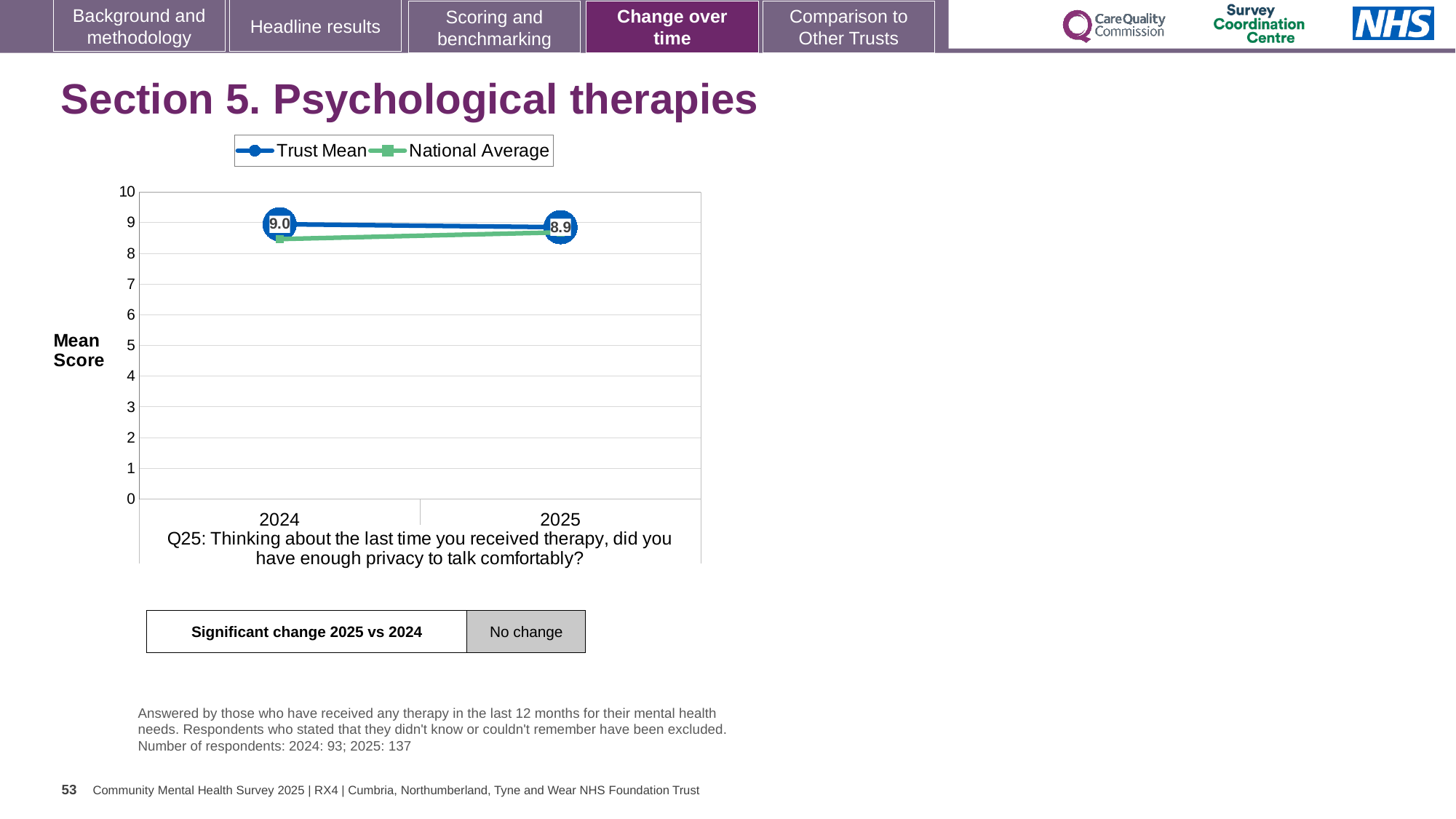
In 2024, which is larger: the Trust Mean or the National Average? Trust Mean Does the Trust Mean rise or fall from 2024 to 2025? fall What kind of chart is shown on the slide? line chart Is the National Average value for 2024 greater or less than 8? greater What is the Trust Mean score for 2025? 8.9 What is the Trust Mean score for 2024? 9.0 What is the difference between the Trust Mean scores for 2024 and 2025? 0.1 What is the label on the y axis of the chart? Mean Score How many years are plotted on the x axis? 2 In which year is the Trust Mean score higher? 2024 Is the National Average value for 2024 greater or less than 9? less How many series does the legend list? 2